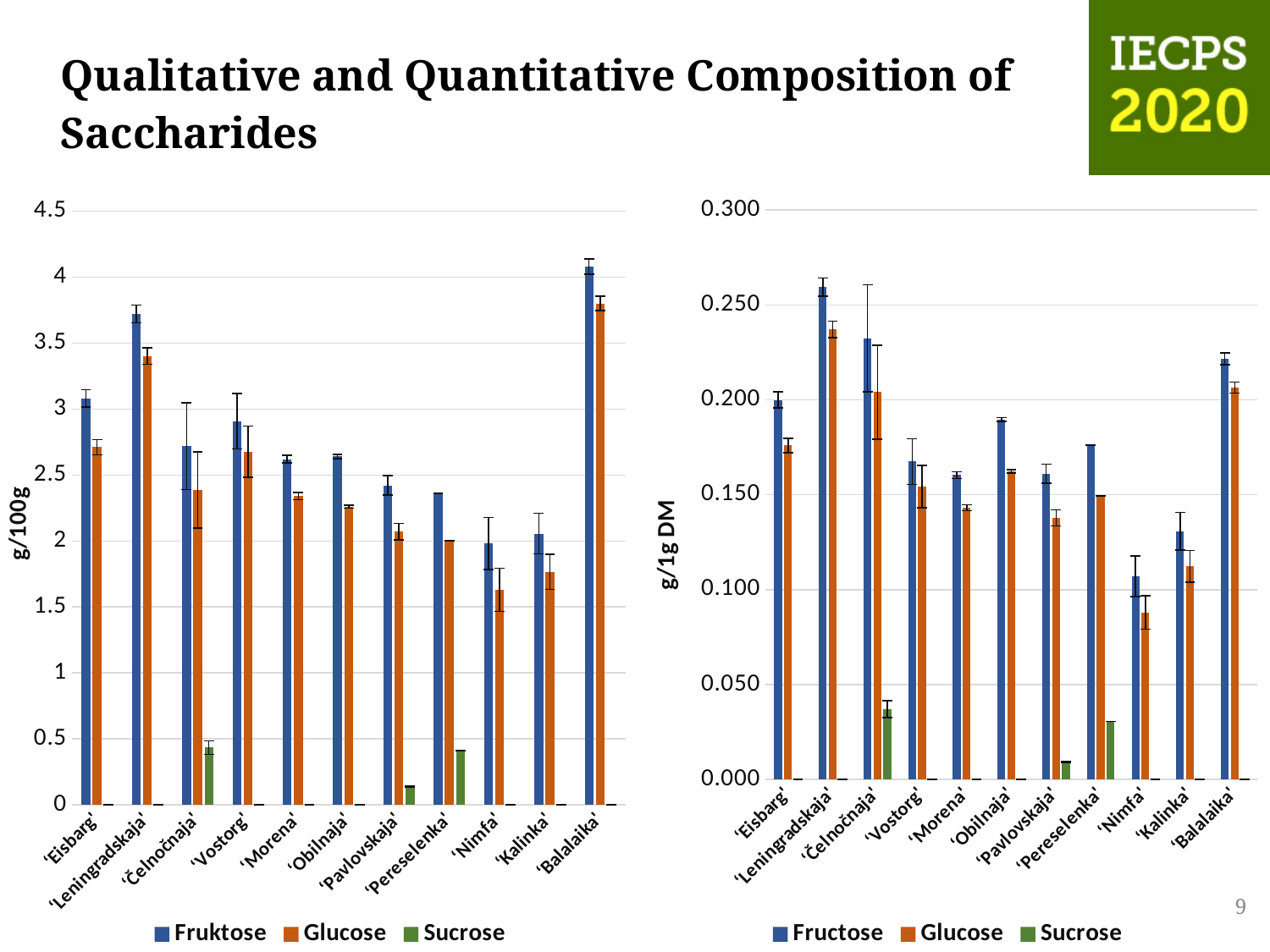
How many series does the legend of the right chart (g/1g DM) list? 3 On the right chart (g/1g DM), which cultivar has the highest Fructose value? 'Leningradskaja' On the left chart (g/100g), which cultivar has the highest Glucose value? 'Balalaika' On the left chart (g/100g), is the Fruktose value for 'Balalaika' greater or less than 4? greater On the right chart (g/1g DM), which cultivar has the lowest Fructose value? 'Nimfa' On the right chart (g/1g DM), is the Fructose value for 'Balalaika' greater or less than 0.200? greater On the left chart (g/100g), is the Glucose value for 'Leningradskaja' greater or less than 3.5? less On the left chart (g/100g), which is larger for 'Eisbarg': Fruktose or Glucose? Fruktose On the left chart (g/100g), which cultivar has the highest Fruktose value? 'Balalaika' How many cultivars are shown on the x axis of the left chart (g/100g)? 11 On the right chart (g/1g DM), which cultivar has the lowest Glucose value? 'Nimfa'